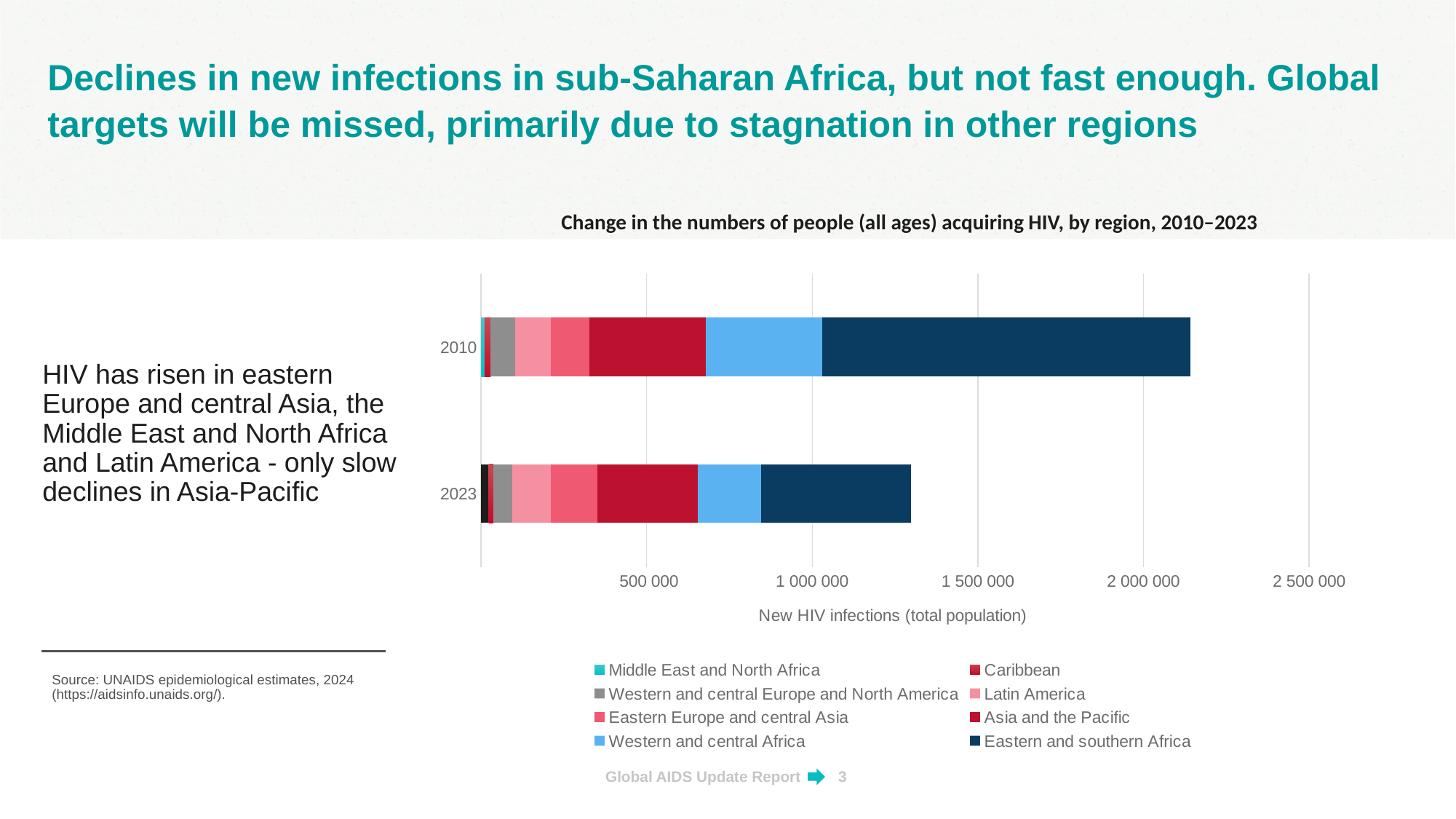
How many years (bars) are plotted in the chart? 2 Is the total number of new HIV infections in 2023 greater or less than 1 500 000? less How many regions does the legend list? 8 What kind of chart is shown on the slide? Stacked bar chart Is the total number of new HIV infections in 2023 greater or less than 1 000 000? greater Is the total number of new HIV infections in 2010 greater or less than 2 000 000? greater Do total new HIV infections rise or fall from 2010 to 2023? fall What is the label of the horizontal axis? New HIV infections (total population) What is the title of the chart? Change in the numbers of people (all ages) acquiring HIV, by region, 2010–2023 Which year has the larger total number of new HIV infections, 2010 or 2023? 2010